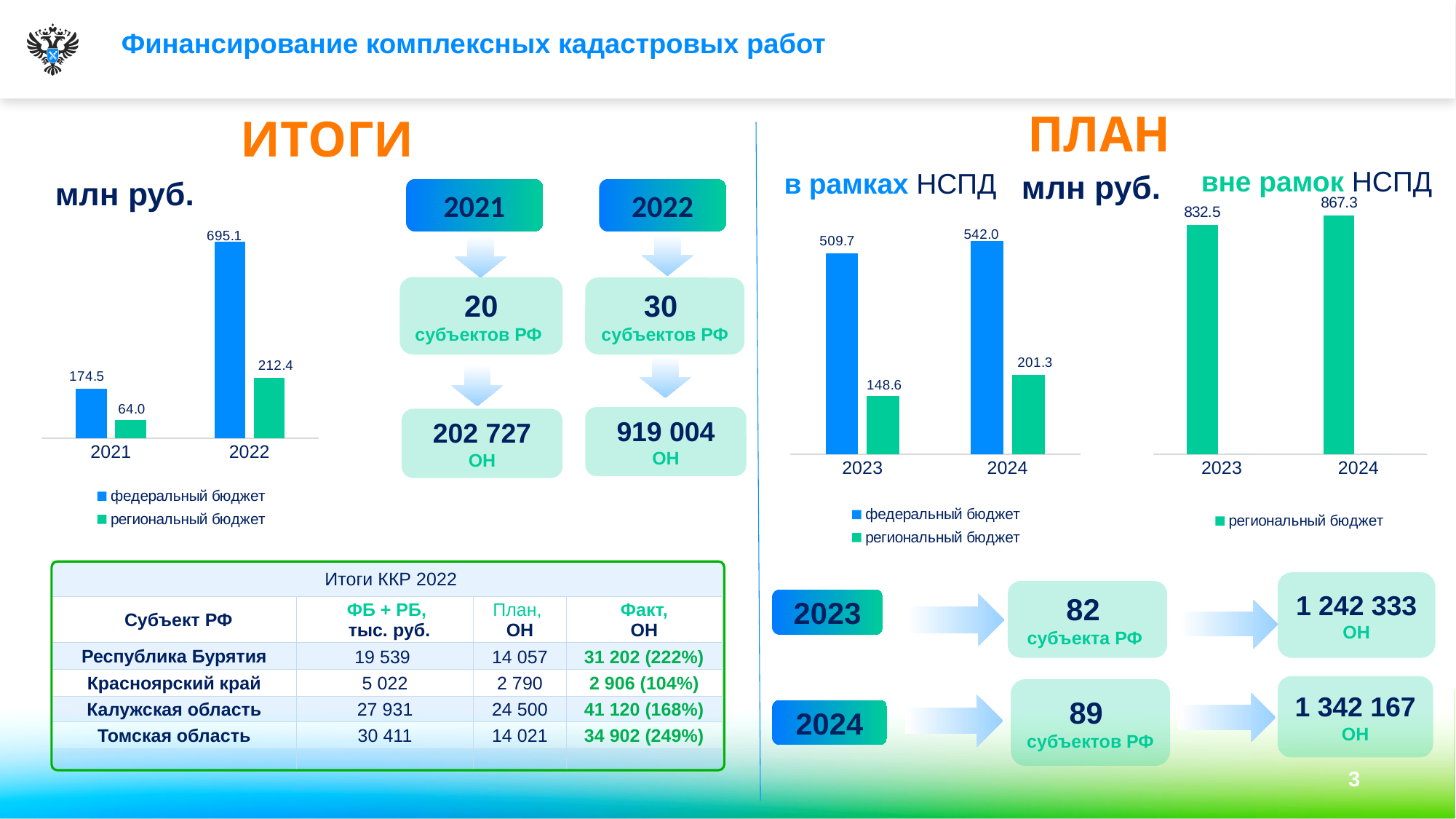
In the 'в рамках НСПД' chart, what is the value for федеральный бюджет in 2024? 542.0 In the 'в рамках НСПД' chart, what is the difference between региональный бюджет in 2024 and in 2023? 52.7 In the ИТОГИ chart on the left, does федеральный бюджет rise or fall from 2021 to 2022? rise In the ИТОГИ chart on the left, what is the value for региональный бюджет in 2021? 64.0 In the ИТОГИ chart on the left, what is the value for федеральный бюджет in 2022? 695.1 In the ИТОГИ chart on the left, what is the difference between федеральный бюджет in 2022 and in 2021? 520.6 What type of chart is the 'вне рамок НСПД' chart? bar chart In the ИТОГИ chart on the left, how many series does the legend list? 2 In the 'вне рамок НСПД' chart, which year has the higher value? 2024 In the 'вне рамок НСПД' chart, what is the value for 2023? 832.5 In the 'в рамках НСПД' chart, which is larger in 2023: федеральный бюджет or региональный бюджет? федеральный бюджет In the 'в рамках НСПД' chart, what is the value for региональный бюджет in 2023? 148.6